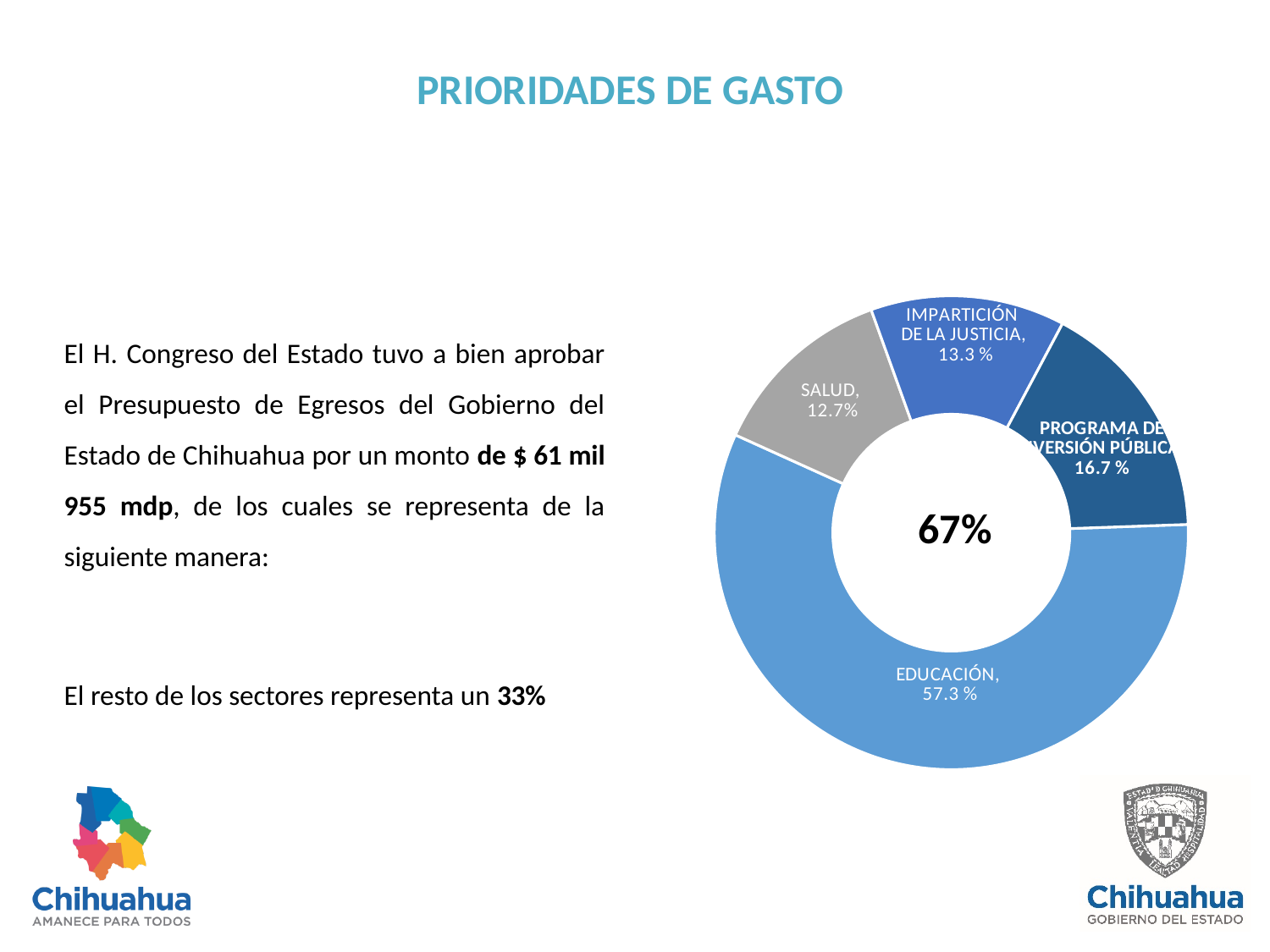
What percentage is shown for PROGRAMA DE INVERSIÓN PÚBLICA? 16.7 % Which is larger, the share for PROGRAMA DE INVERSIÓN PÚBLICA or the share for SALUD? PROGRAMA DE INVERSIÓN PÚBLICA Which sector has the largest share in the chart? EDUCACIÓN What is the difference in percentage points between EDUCACIÓN and SALUD? 44.6 Which sector has the smallest share in the chart? SALUD What percentage is shown for SALUD in the chart? 12.7 % How many sectors (slices) are shown in the chart? 4 What percentage does the EDUCACIÓN slice represent in the doughnut chart? 57.3 % What value is printed in the centre of the doughnut chart? 67% What percentage is shown for IMPARTICIÓN DE LA JUSTICIA? 13.3 % What is the difference in percentage points between PROGRAMA DE INVERSIÓN PÚBLICA and IMPARTICIÓN DE LA JUSTICIA? 3.4 What kind of chart is shown on the slide? Doughnut chart